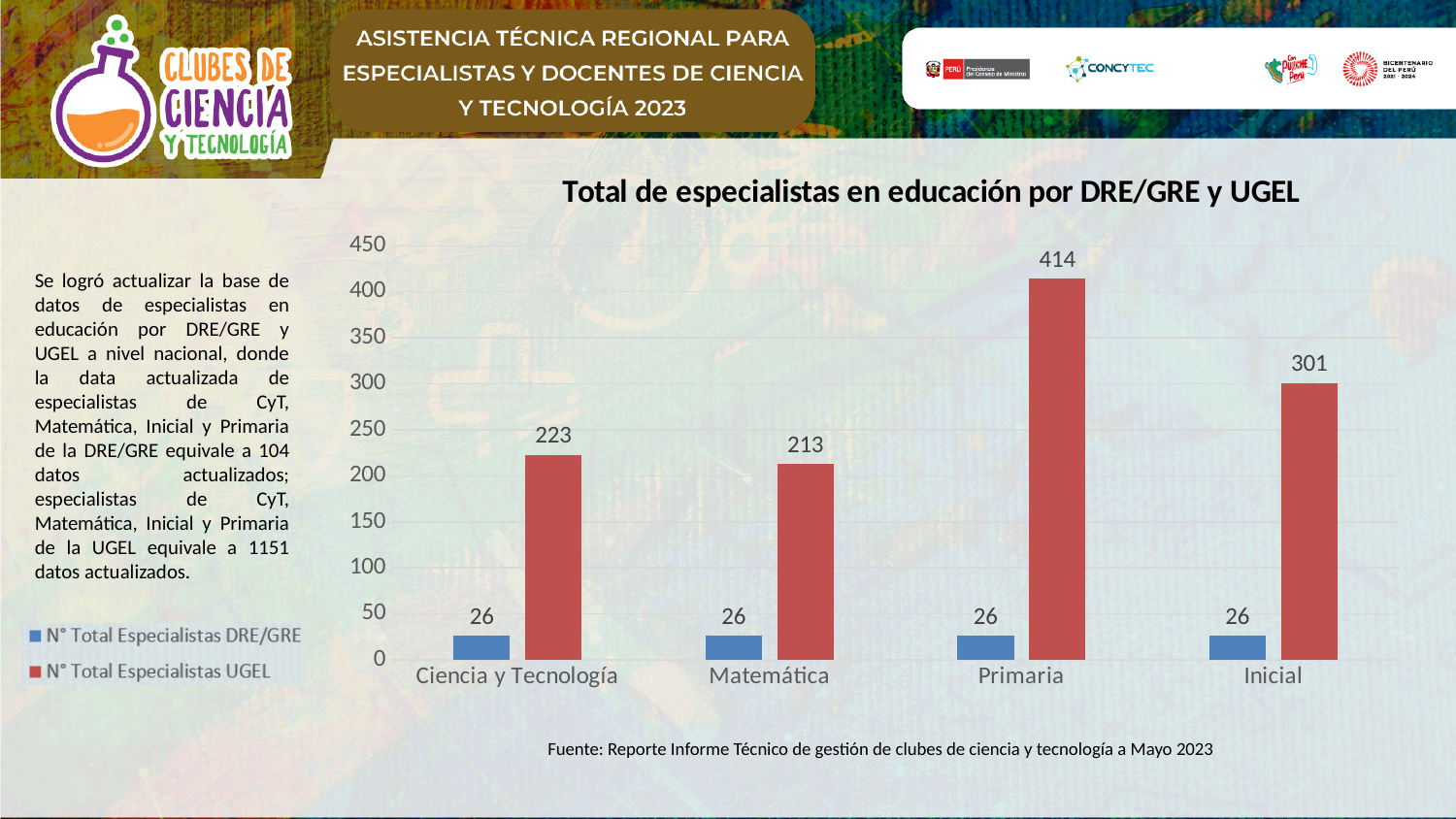
What is the value of N° Total Especialistas DRE/GRE for Matemática? 26 How many categories are shown on the x axis? 4 What is the difference between the N° Total Especialistas UGEL values for Primaria and Inicial? 113 Which is larger: the N° Total Especialistas UGEL value for Ciencia y Tecnología or for Inicial? Inicial What is the value of N° Total Especialistas UGEL for Primaria? 414 What is the value of N° Total Especialistas UGEL for Ciencia y Tecnología? 223 Which category has the lowest value for N° Total Especialistas UGEL? Matemática What is the title of the chart? Total de especialistas en educación por DRE/GRE y UGEL What kind of chart is shown on the slide? Bar chart Which category has the highest value for N° Total Especialistas UGEL? Primaria How many series does the legend list? 2 Is the N° Total Especialistas UGEL value for Inicial greater or less than 250? greater